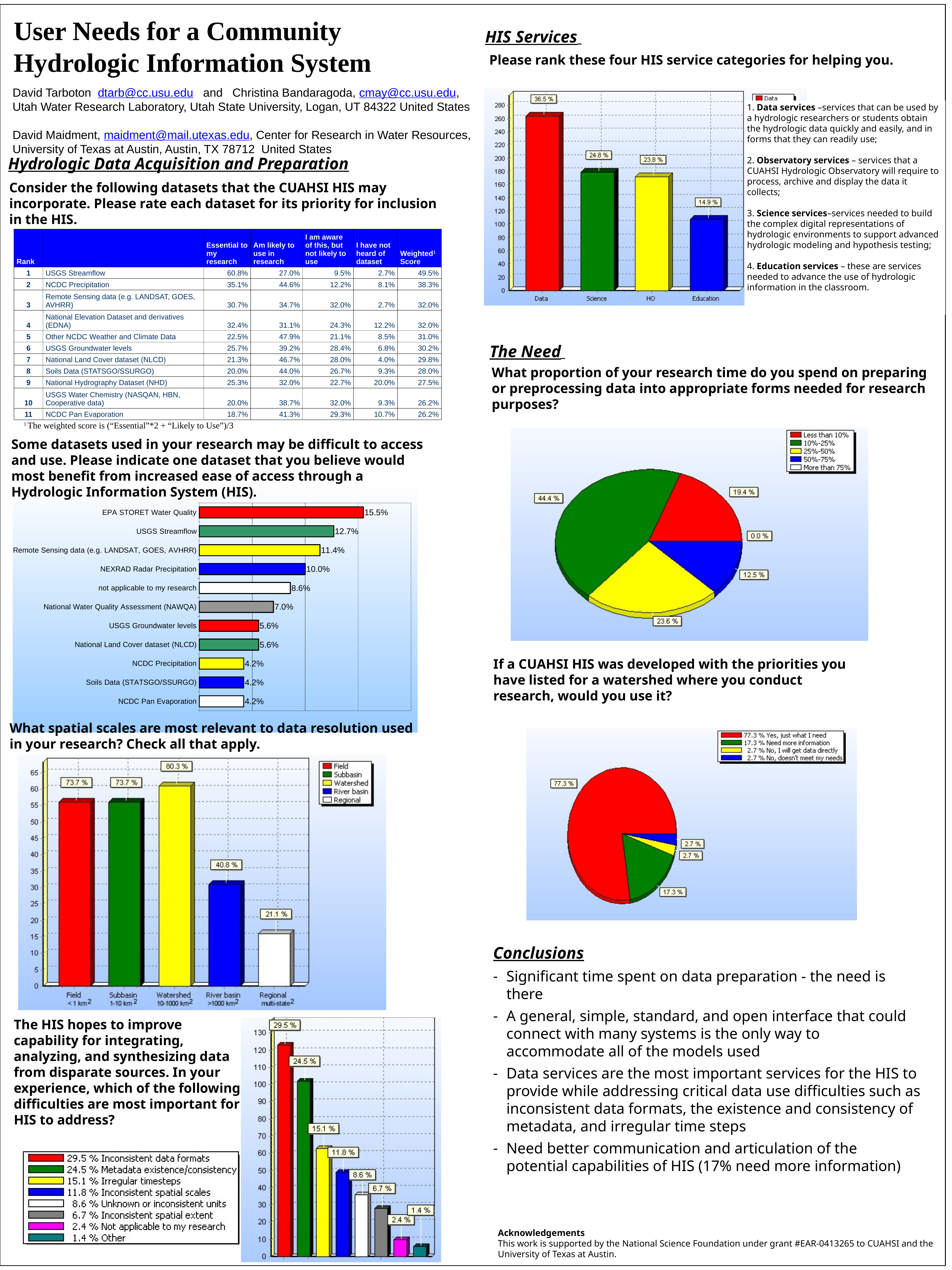
In the HIS Services bar chart, what is the difference between the Data and Education percentages? 21.6 % In the pie chart under 'The Need', what share is shown for the 10%-25% slice? 44.4 % In the pie chart under 'The Need', how many categories does the legend list? 5 In the HIS Services bar chart, which service category has the lowest value? Education In the spatial scales bar chart, which is larger, River basin or Regional? River basin In the horizontal bar chart of datasets that would benefit from increased ease of access, how many bars are plotted? 11 In the spatial scales bar chart, which scale has the highest percentage? Watershed In the horizontal bar chart of datasets that would benefit from increased ease of access, what is the value for NEXRAD Radar Precipitation? 10.0% In the pie chart asking whether you would use a CUAHSI HIS, what percentage answered 'Yes, just what I need'? 77.3 % In the HIS Services bar chart, what percentage is shown for Data? 36.5 % In the horizontal bar chart of datasets that would benefit from increased ease of access, which dataset has the highest value? EPA STORET Water Quality In the bar chart of difficulties for HIS to address, what percentage is shown for Irregular timesteps? 15.1 %